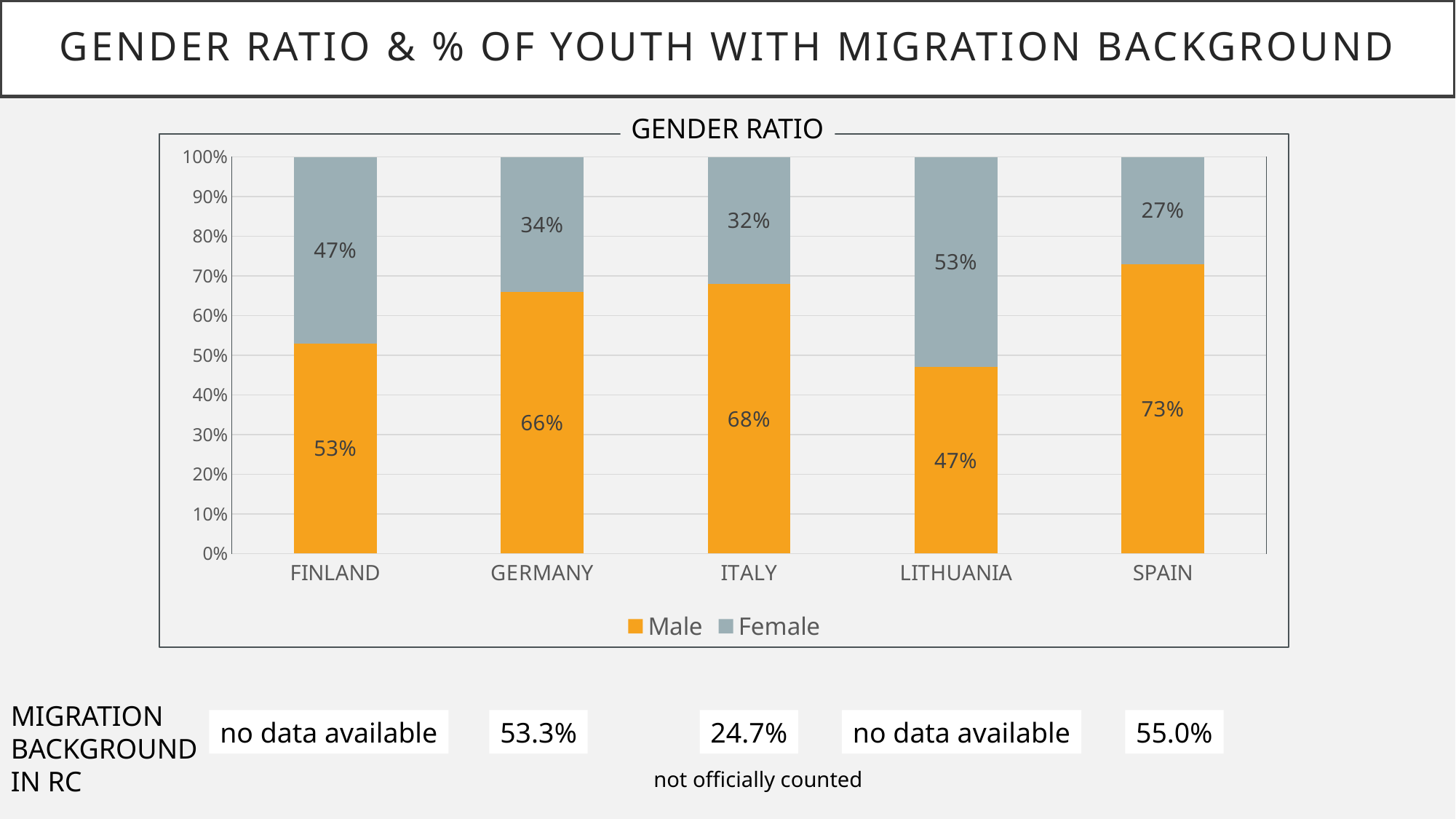
What is the title of the chart? GENDER RATIO What kind of chart is shown? Stacked bar chart How many series does the legend list? 2 What is the difference between the Male and Female values for Italy? 36% How many countries are shown on the x axis? 5 What is the Male value for Germany? 66% Which is larger, the Male value for Finland or the Male value for Germany? Germany What is the total of the stacked bar for Lithuania? 100% What is the Male value for Lithuania? 47% What is the Female value for Spain? 27% Which country has the lowest Female share? Spain Which country has the highest Male share? Spain